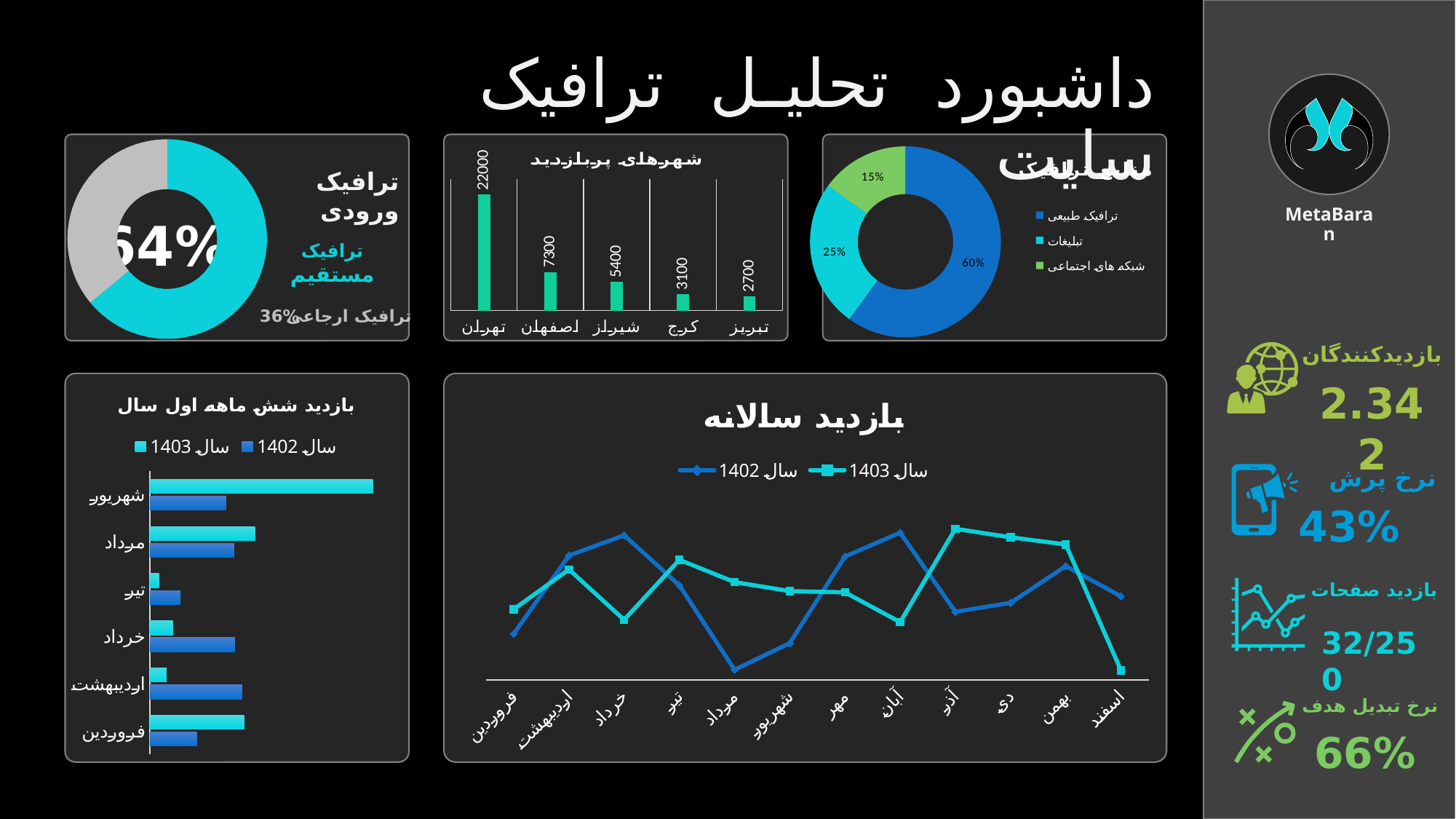
How many cities are shown in the bar chart titled "شهرهای پربازدید"? 5 In the top-right donut chart, which legend entry has the largest share? ترافیک طبیعی How many categories are shown on the x axis of the chart titled "بازدید سالانه"? 12 In the bar chart titled "شهرهای پربازدید", what is the difference between the values for اصفهان and کرج? 4200 How many series does the legend of the chart titled "بازدید سالانه" list? 2 In the bar chart titled "شهرهای پربازدید", which city has the lowest value? تبریز In the chart titled "بازدید شش ماهه اول سال", which series has the larger value for شهریور, سال 1403 or سال 1402? سال 1403 In the top-right donut chart, what share does "تبلیغات" have? 25% What kind of chart is the chart titled "بازدید سالانه"? line chart In the top-left donut chart titled "ترافیک ورودی", what is the value for "ترافیک ارجاعی"? 36% In the bar chart titled "شهرهای پربازدید", what is the value for شیراز? 5400 In the bar chart titled "شهرهای پربازدید", what is the value for تهران? 22000